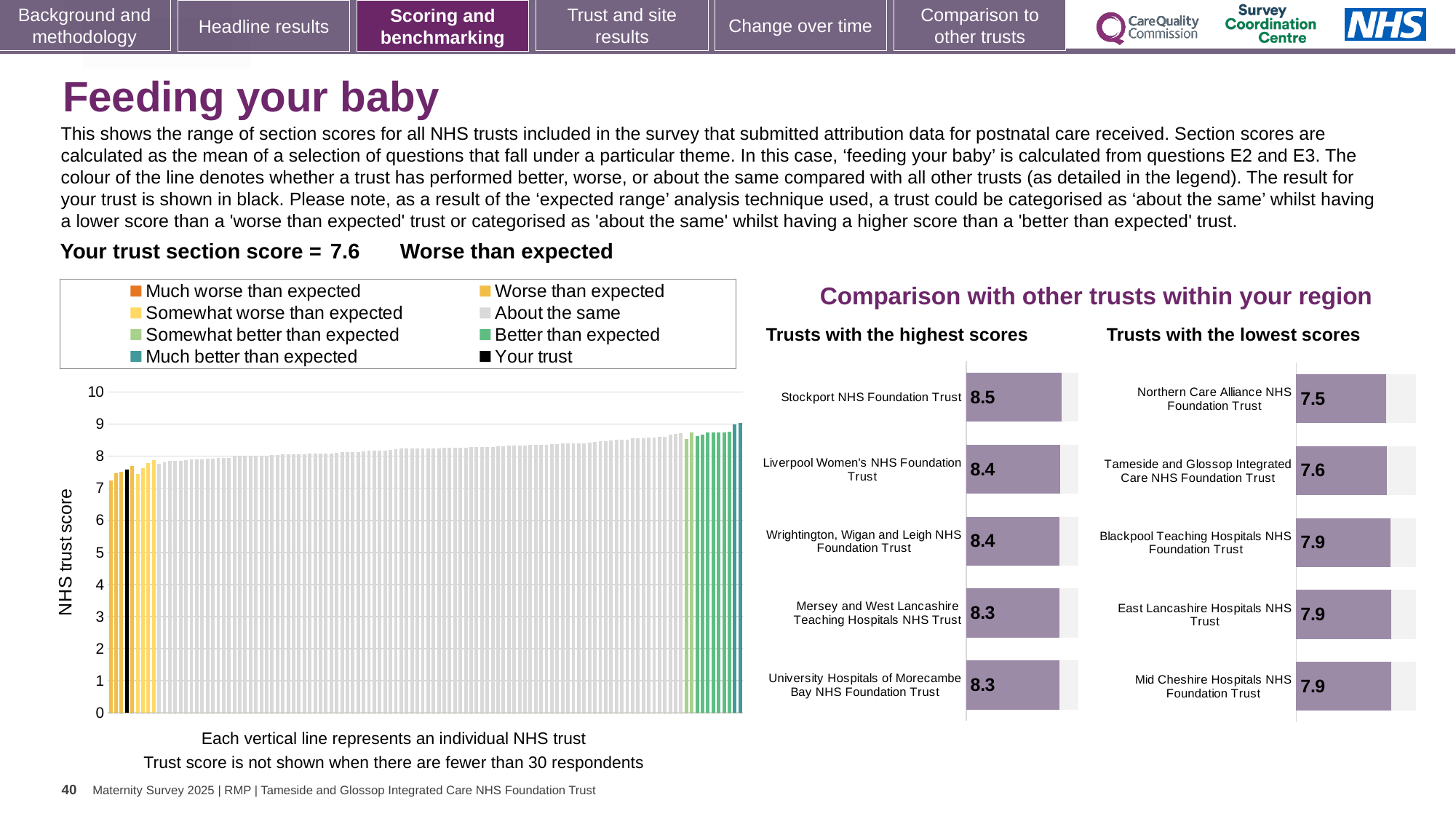
In the 'Trusts with the highest scores' chart, what is the difference between the scores of Stockport NHS Foundation Trust and University Hospitals of Morecambe Bay NHS Foundation Trust? 0.2 In the large chart on the left, what is the label on the y axis? NHS trust score In the large chart on the left, do the trust scores rise or fall from left to right along the x axis? rise In the 'Trusts with the highest scores' chart, how many trusts are shown? 5 In the 'Trusts with the lowest scores' chart, which has the larger score: Blackpool Teaching Hospitals NHS Foundation Trust or Northern Care Alliance NHS Foundation Trust? Blackpool Teaching Hospitals NHS Foundation Trust In the 'Trusts with the highest scores' chart, which trust has the highest score? Stockport NHS Foundation Trust In the 'Trusts with the lowest scores' chart, what is the score for Tameside and Glossop Integrated Care NHS Foundation Trust? 7.6 In the 'Trusts with the highest scores' chart, what is the score for Stockport NHS Foundation Trust? 8.5 What kind of chart is the large chart on the left with the y axis labelled 'NHS trust score'? bar chart In the large chart on the left, how many entries does the legend list? 8 In the 'Trusts with the lowest scores' chart, which trust has the lowest score? Northern Care Alliance NHS Foundation Trust In the large chart on the left, is the value of the black 'Your trust' bar greater or less than 8? less